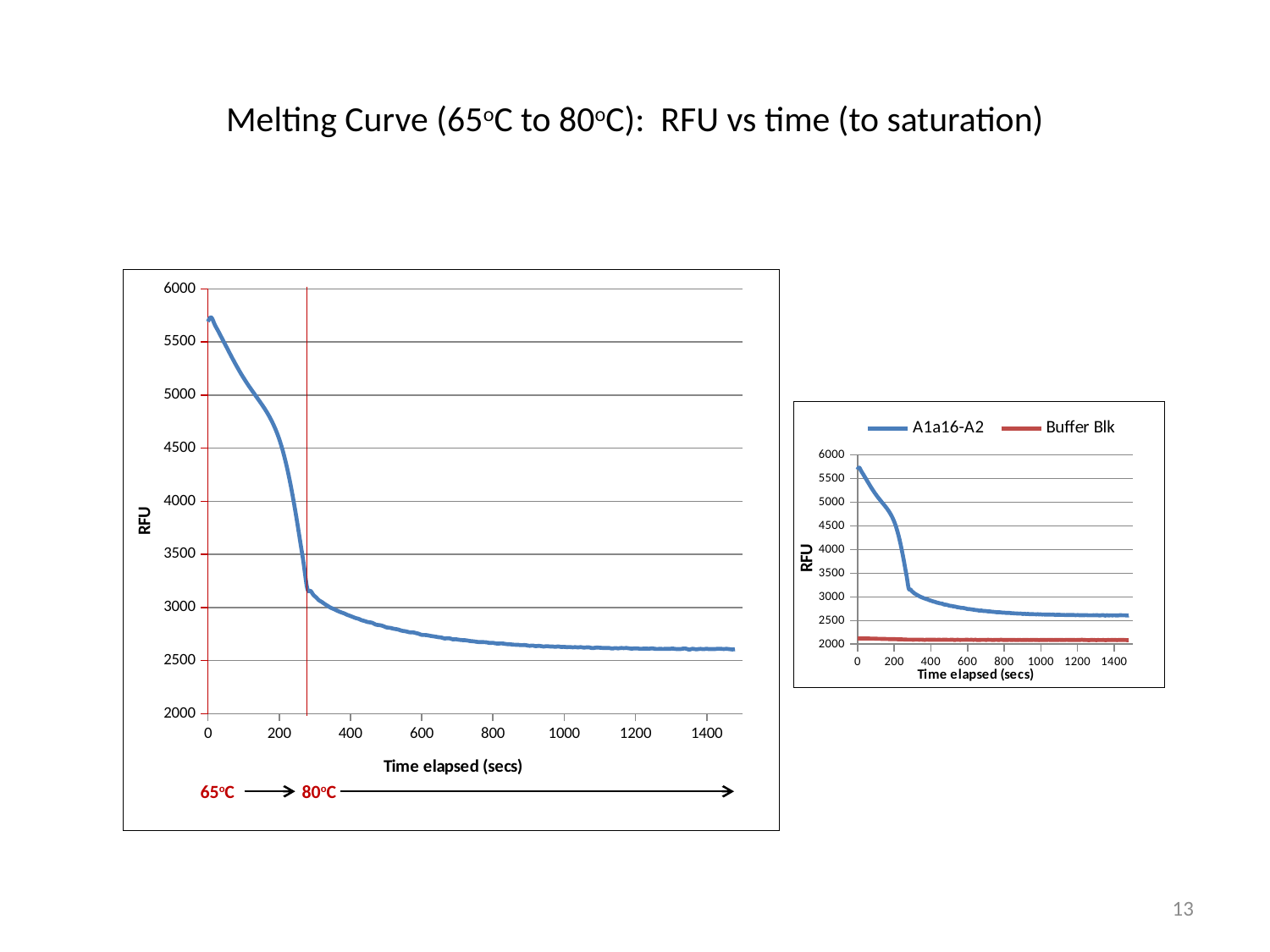
What is the x-axis title of the large chart on the left? Time elapsed (secs) In the small chart on the right, is the Buffer Blk value at 1400 secs greater or less than 2500? less In the large chart on the left, is the RFU value at 100 secs greater or less than 5000? greater What kind of chart is the large chart on the left of the slide? line chart How many series does the legend of the small chart on the right list? 2 In the large chart on the left, do the RFU values rise or fall as time elapsed increases? fall In the small chart on the right, do the A1a16-A2 values rise or fall as time elapsed increases? fall In the large chart on the left, is the RFU value at time 0 greater or less than 5500? greater In the small chart on the right, which series has the higher RFU values, A1a16-A2 or Buffer Blk? A1a16-A2 What is the y-axis title of the large chart on the left? RFU